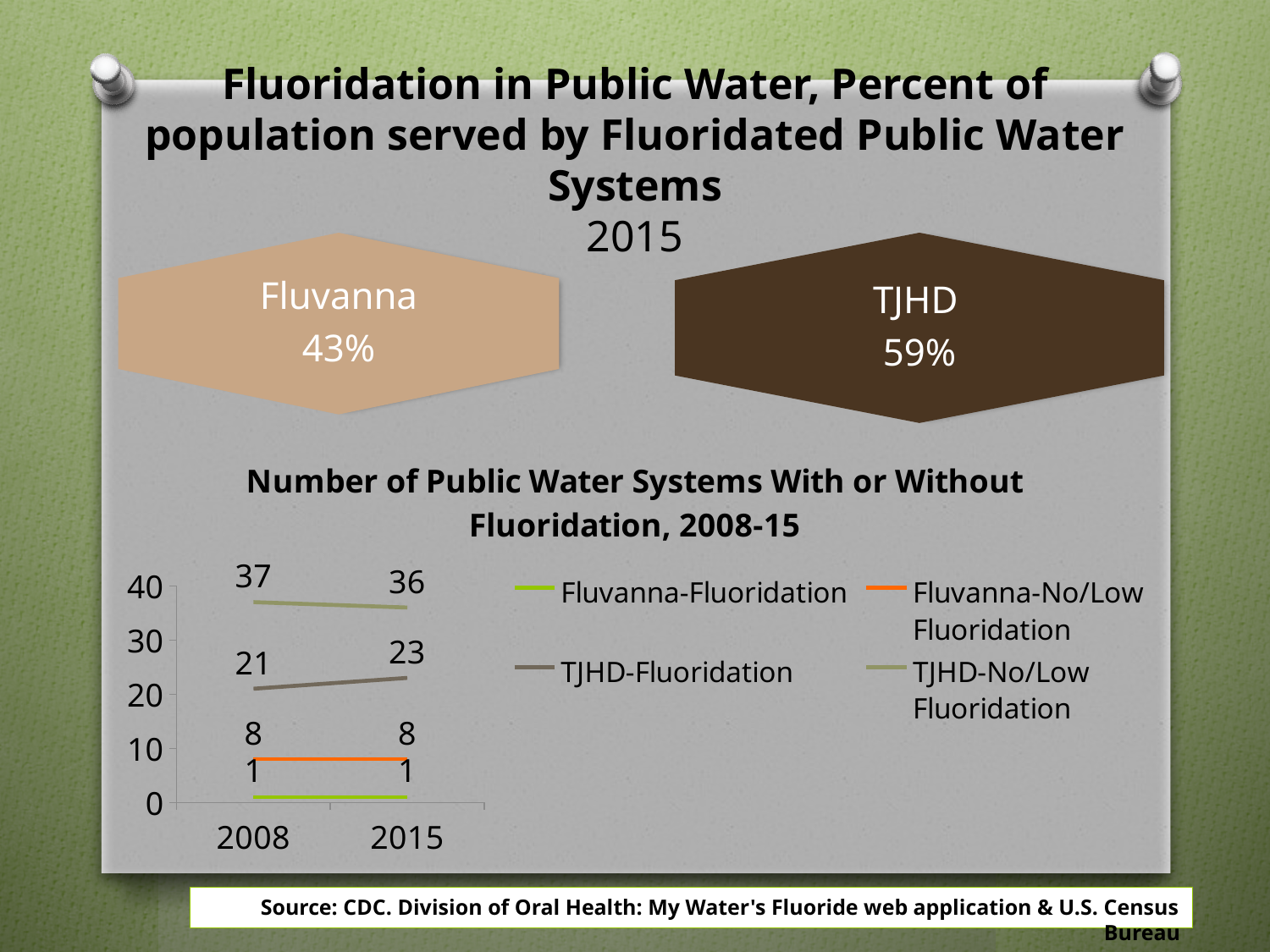
In the "Number of Public Water Systems" chart, what is the value for Fluvanna-Fluoridation in 2008? 1 How many series does the legend of the "Number of Public Water Systems" chart list? 4 How many years are shown on the x axis of the "Number of Public Water Systems" chart? 2 In the "Number of Public Water Systems" chart, which series has the highest value in 2015? TJHD-No/Low Fluoridation In the "Number of Public Water Systems" chart, does the TJHD-Fluoridation series rise or fall from 2008 to 2015? rise In the "Number of Public Water Systems" chart, which series has the lowest value in 2008? Fluvanna-Fluoridation In the "Number of Public Water Systems" chart, what is the value for TJHD-No/Low Fluoridation in 2008? 37 In the "Number of Public Water Systems" chart, what is the value for TJHD-Fluoridation in 2015? 23 In the "Number of Public Water Systems" chart, what is the value for Fluvanna-No/Low Fluoridation in 2015? 8 In the "Number of Public Water Systems" chart, which is larger in 2008: TJHD-Fluoridation or Fluvanna-No/Low Fluoridation? TJHD-Fluoridation What kind of chart is "Number of Public Water Systems With or Without Fluoridation, 2008-15"? line chart In the "Number of Public Water Systems" chart, what is the difference between TJHD-No/Low Fluoridation and TJHD-Fluoridation in 2015? 13